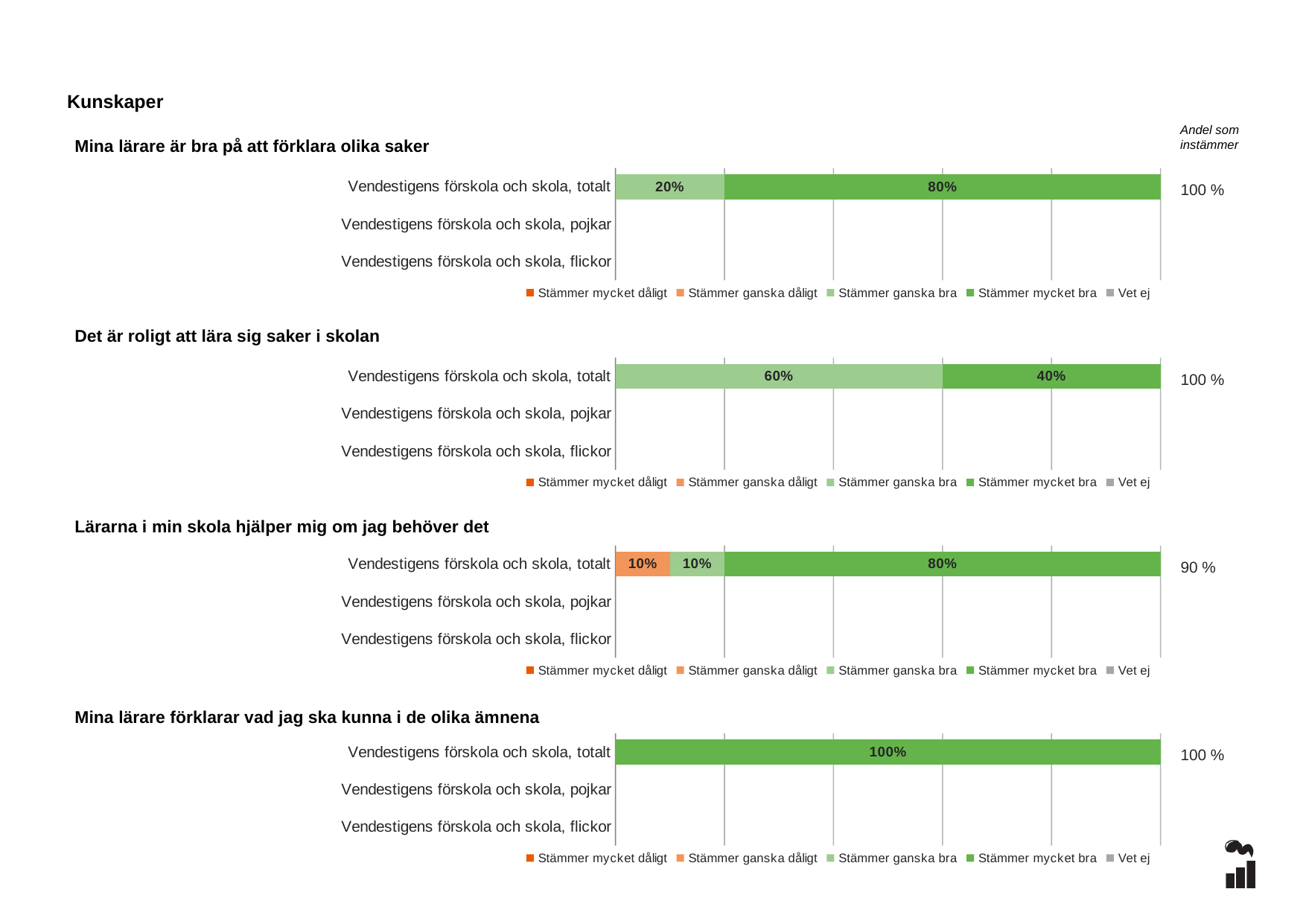
In the chart 'Det är roligt att lära sig saker i skolan', which is larger for 'Vendestigens förskola och skola, totalt': 'Stämmer ganska bra' or 'Stämmer mycket bra'? Stämmer ganska bra In the chart 'Mina lärare är bra på att förklara olika saker', what is the value of 'Stämmer ganska bra' for 'Vendestigens förskola och skola, totalt'? 20% In the chart 'Lärarna i min skola hjälper mig om jag behöver det', which series has the highest value for 'Vendestigens förskola och skola, totalt'? Stämmer mycket bra In the chart 'Lärarna i min skola hjälper mig om jag behöver det', what is the 'Andel som instämmer' value shown for 'Vendestigens förskola och skola, totalt'? 90 % In the chart 'Lärarna i min skola hjälper mig om jag behöver det', what is the value of 'Stämmer ganska dåligt' for 'Vendestigens förskola och skola, totalt'? 10% In the chart 'Mina lärare är bra på att förklara olika saker', what is the value of 'Stämmer mycket bra' for 'Vendestigens förskola och skola, totalt'? 80% In the chart 'Det är roligt att lära sig saker i skolan', what is the difference between 'Stämmer ganska bra' and 'Stämmer mycket bra' for 'Vendestigens förskola och skola, totalt'? 20% How many categories are shown on the y axis of the chart 'Det är roligt att lära sig saker i skolan'? 3 What kind of chart is 'Lärarna i min skola hjälper mig om jag behöver det'? Stacked bar chart In the chart 'Det är roligt att lära sig saker i skolan', what is the value of 'Stämmer ganska bra' for 'Vendestigens förskola och skola, totalt'? 60% In the chart 'Mina lärare förklarar vad jag ska kunna i de olika ämnena', what is the value of 'Stämmer mycket bra' for 'Vendestigens förskola och skola, totalt'? 100% How many series does the legend list in the chart 'Mina lärare är bra på att förklara olika saker'? 5